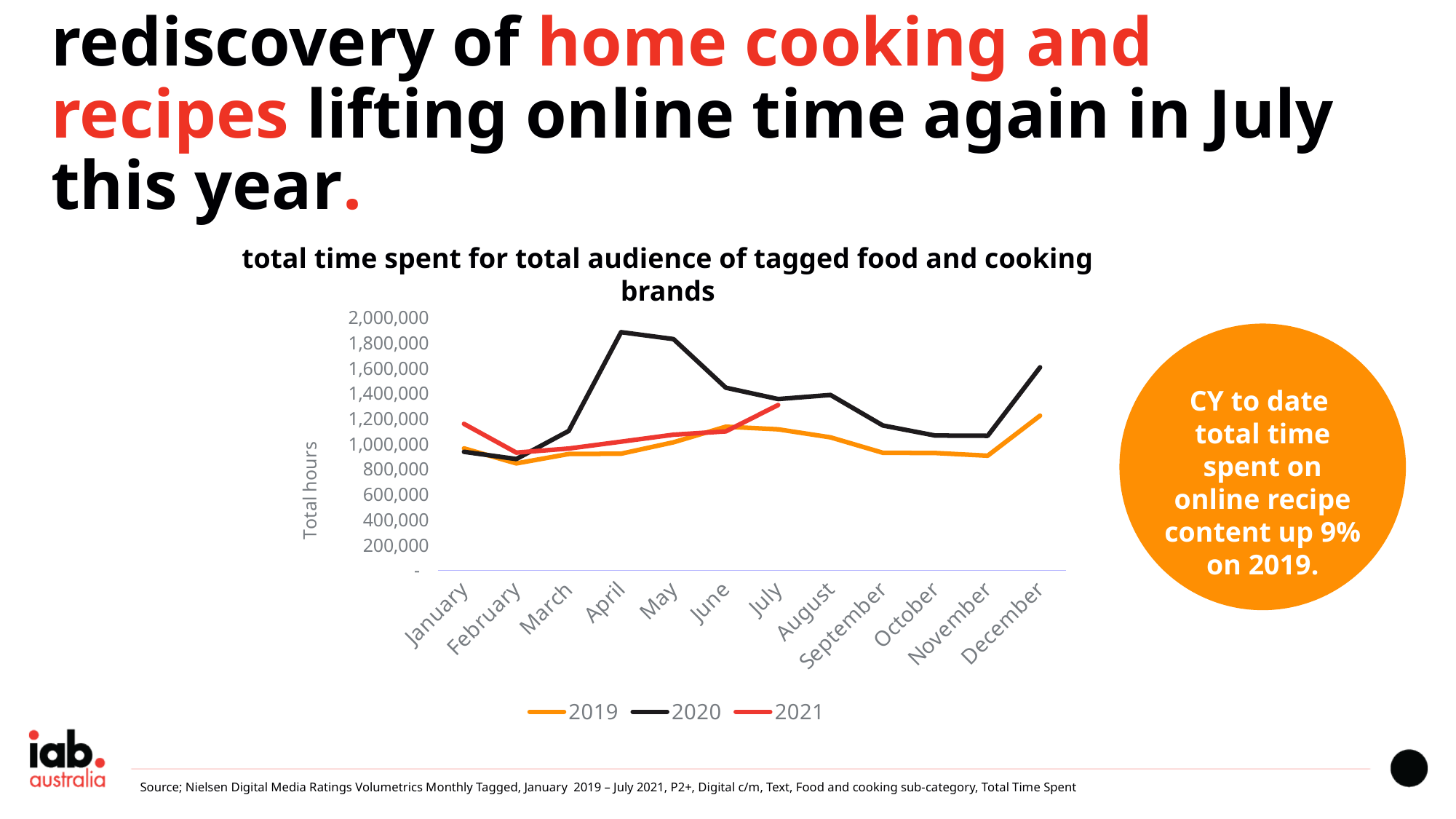
What is the label on the y axis? Total hours How many months are shown along the x axis? 12 Does the 2021 line rise or fall from February to July? rise Which colour represents the 2020 series in the legend? black Is the 2019 value for February greater or less than 1,000,000? less How many series does the legend list? 3 Which series has the larger value in January, 2020 or 2021? 2021 Is the 2020 value for April greater or less than 1,800,000? greater What kind of chart is shown on the slide? line chart In which month does the 2020 line reach its highest value? April Which series has the larger value in April, 2019 or 2020? 2020 Is the 2021 value for July greater or less than 1,200,000? greater